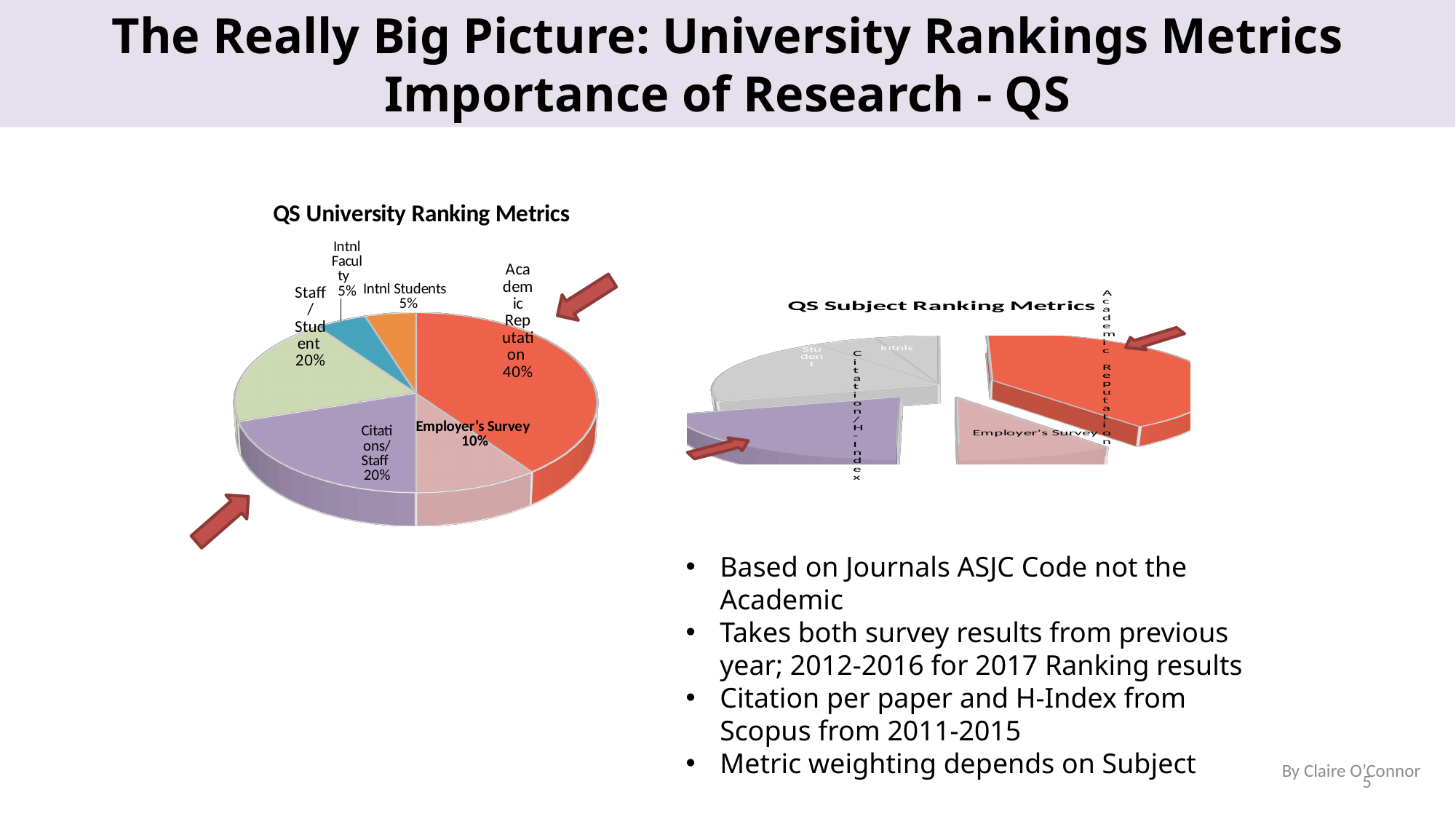
How many slices does the QS University Ranking Metrics pie chart have? 6 In the QS University Ranking Metrics chart, what is the difference between the Academic Reputation share and the Employer's Survey share? 30% What is the title of the chart on the right side of the slide? QS Subject Ranking Metrics In the QS University Ranking Metrics chart, what share does Citations/Staff have? 20% What kind of chart is the QS Subject Ranking Metrics chart on the right? Pie chart In the QS University Ranking Metrics chart, what is the combined share of Intnl Faculty and Intnl Students? 10% In the QS University Ranking Metrics chart, which is larger: Staff/Student or Intnl Faculty? Staff/Student What kind of chart is the QS University Ranking Metrics chart? Pie chart In the QS University Ranking Metrics chart, what share does Intnl Students have? 5% In the QS University Ranking Metrics chart, what share does Employer's Survey have? 10% In the QS University Ranking Metrics chart, what share does Academic Reputation have? 40% In the QS University Ranking Metrics chart, which metric has the largest share? Academic Reputation